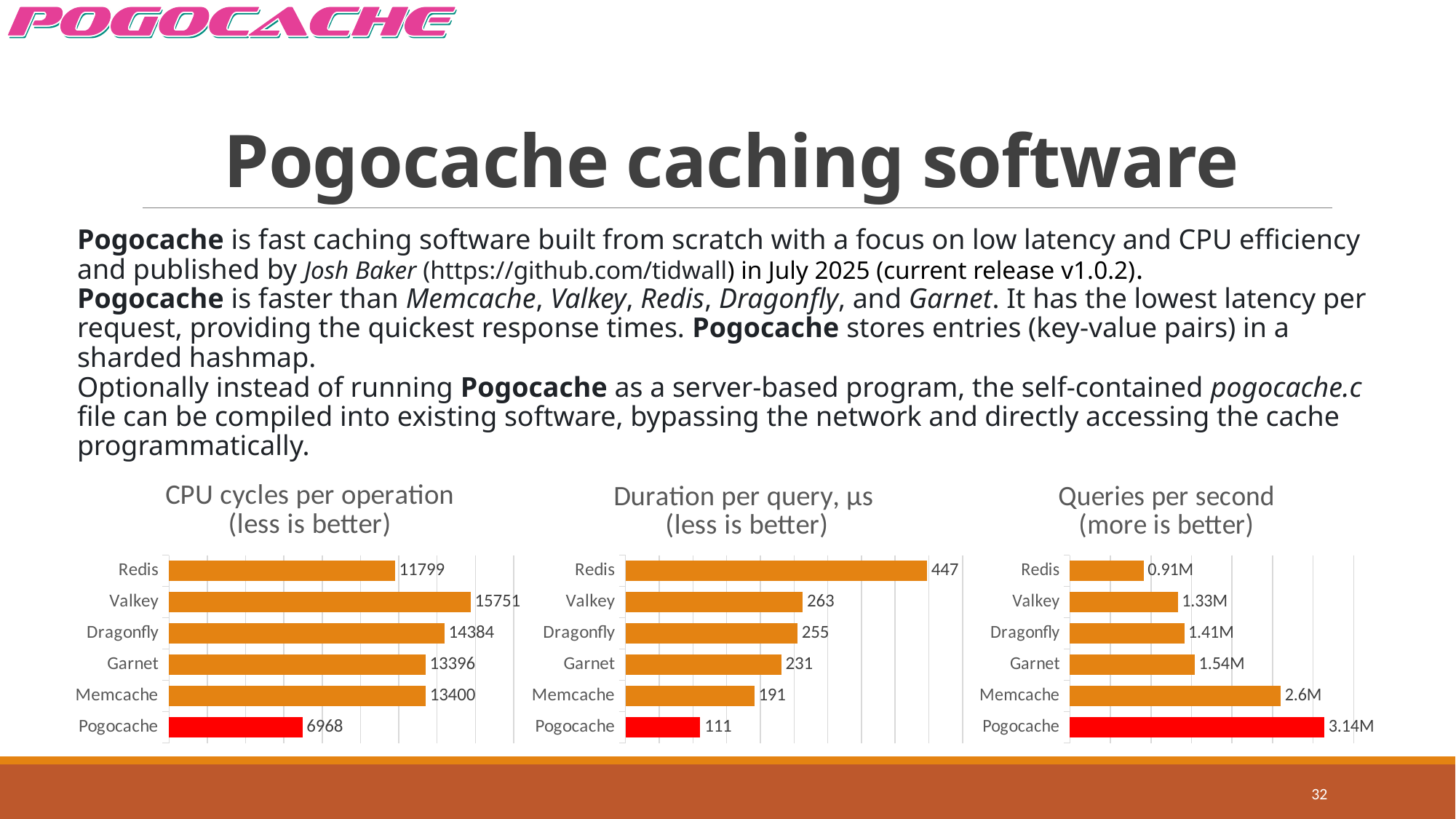
How many categories are shown in the 'Duration per query, µs' chart? 6 In the 'Duration per query, µs' chart, what is the value for Redis? 447 In the 'Queries per second' chart, which is larger, Garnet or Dragonfly? Garnet In the 'CPU cycles per operation' chart, what is the value for Valkey? 15751 In the 'Queries per second' chart, what is the value for Memcache? 2.6M In the 'Duration per query, µs' chart, what is the difference between Memcache and Pogocache? 80 In the 'CPU cycles per operation' chart, which category has the lowest value? Pogocache In the 'Duration per query, µs' chart, which category has the highest value? Redis In the 'CPU cycles per operation' chart, what is the difference between Valkey and Pogocache? 8783 In the 'CPU cycles per operation' chart, which bar is coloured red? Pogocache In the 'Queries per second' chart, which category has the highest value? Pogocache What kind of chart is the 'Queries per second' chart? Bar chart